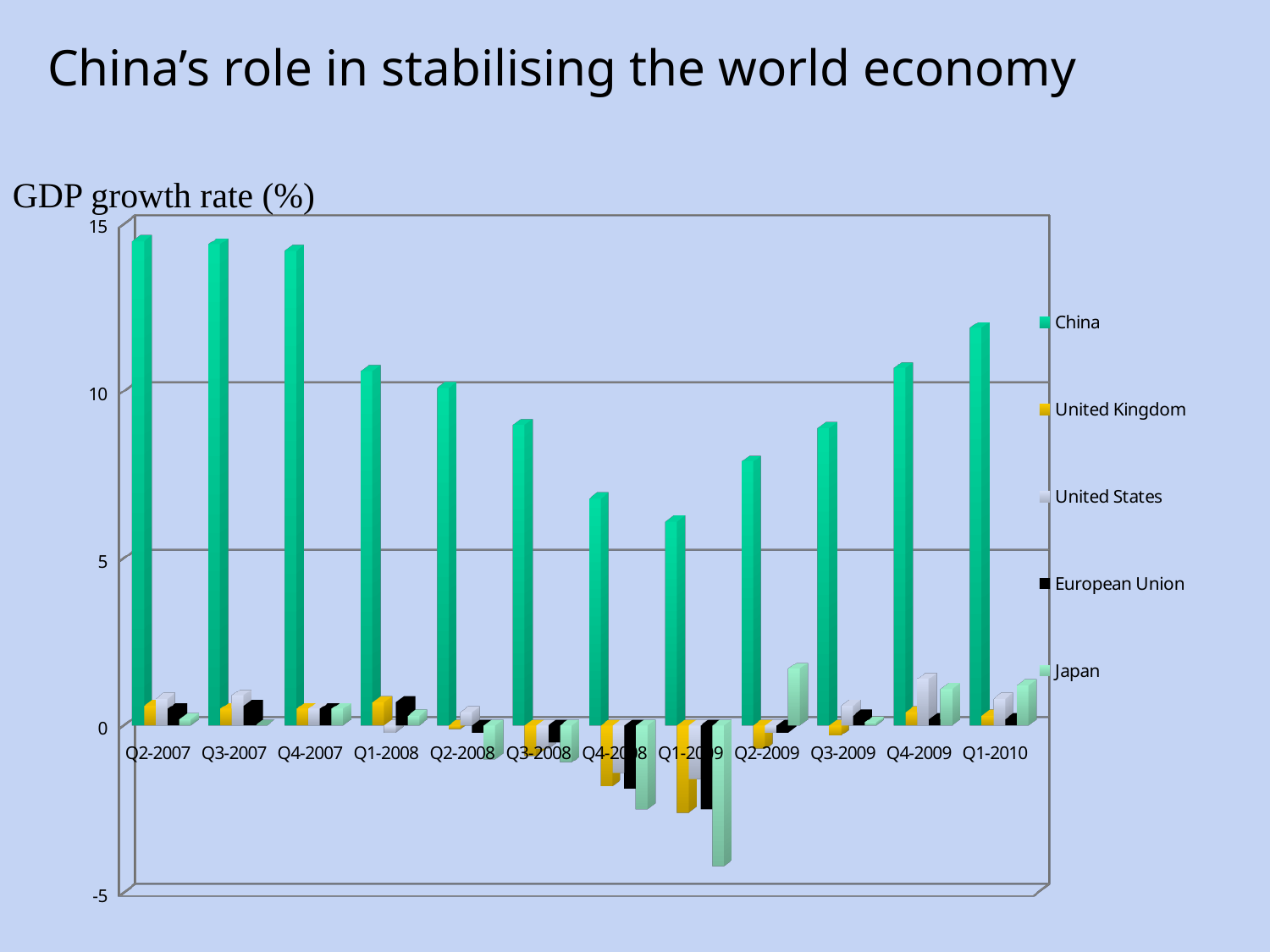
How many quarters are shown along the x axis? 12 Is the value for China in Q1-2009 greater or less than 5? greater Which is larger, China's value in Q2-2009 or in Q3-2009? Q3-2009 Is the value for China in Q2-2007 greater or less than 10? greater How many series does the legend list? 5 What is the label shown above the chart's vertical axis? GDP growth rate (%) Is the value for Japan in Q1-2009 greater or less than 0? less Which series has the highest value in every quarter shown? China What kind of chart is shown on the slide? bar chart Do China's values rise or fall from Q2-2007 to Q1-2009? fall In which quarter is China's GDP growth rate lowest? Q1-2009